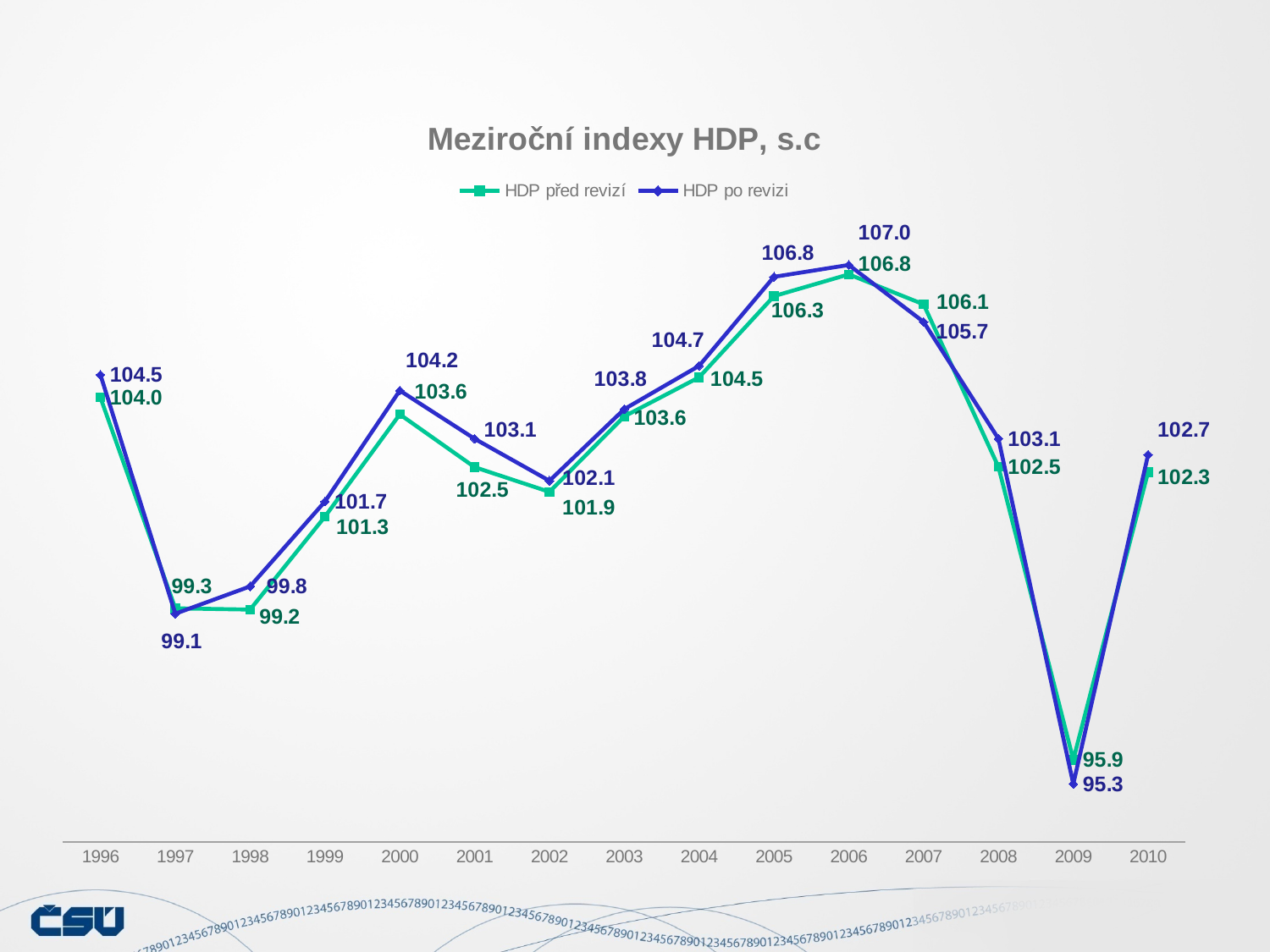
How many years are shown on the x axis? 15 In which year is HDP po revizi at its highest? 2006 What is the value of HDP před revizí in 2000? 103.6 What is the difference between HDP po revizi and HDP před revizí in 2009? 0.6 In which year is HDP před revizí at its lowest? 2009 Do the values of HDP po revizi rise or fall from 2006 to 2009? fall How many series does the legend list? 2 What type of chart is shown on the slide? line chart What is the value of HDP před revizí in 2009? 95.9 What is the title of the chart? Meziroční indexy HDP, s.c What is the value of HDP po revizi in 2006? 107.0 Which series has the larger value in 2007, HDP před revizí or HDP po revizi? HDP před revizí